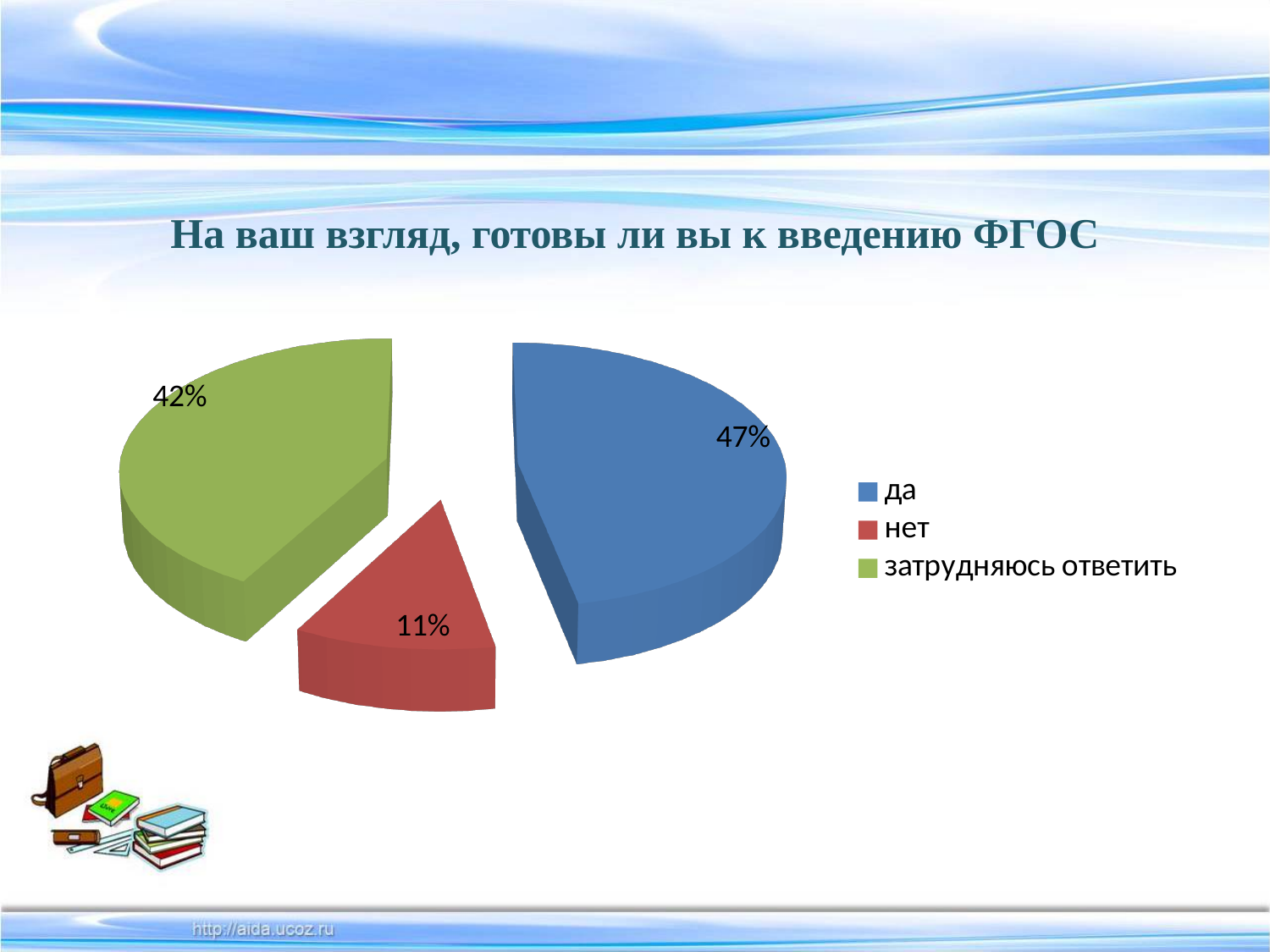
Which answer has the smallest share of the pie? нет What share of respondents answered "затрудняюсь ответить"? 42% Which answer has the largest share of the pie? да How many entries does the legend list? 3 How many slices does the pie chart have? 3 What is the difference in percentage points between "да" and "нет"? 36 What kind of chart is shown on the slide? pie chart What share of respondents answered "да"? 47% What colour is the slice for "нет"? red Which is larger, the share for "нет" or the share for "затрудняюсь ответить"? затрудняюсь ответить What is the difference in percentage points between "да" and "затрудняюсь ответить"? 5 What share of respondents answered "нет"? 11%